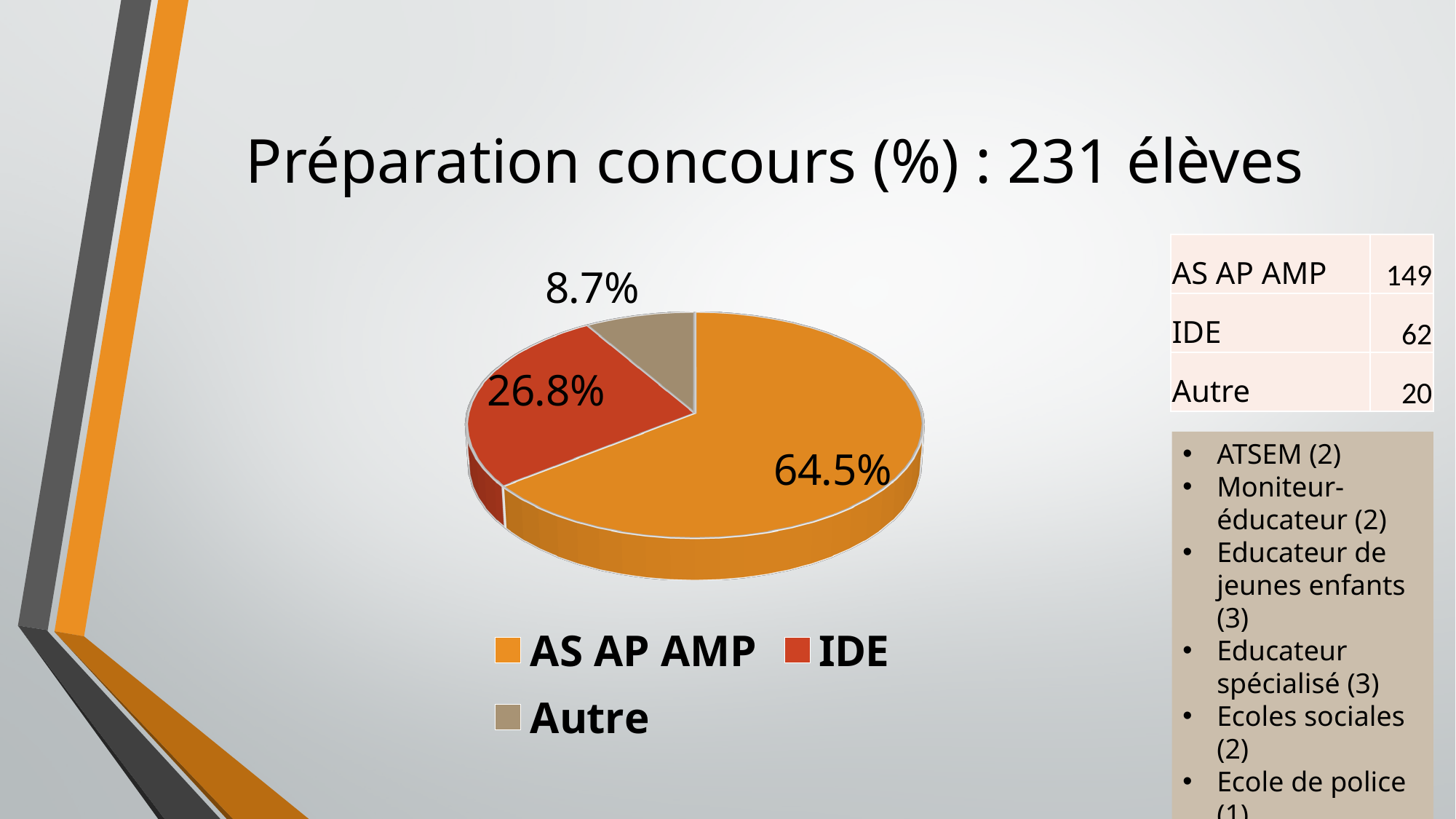
Which slice is larger, IDE or Autre? IDE What type of chart is shown on the slide? Pie chart What is the title of the slide containing the pie chart? Préparation concours (%) : 231 élèves Which category has the smallest slice in the pie chart? Autre What colour is the IDE slice in the pie chart? Red What percentage of the pie chart does the IDE slice represent? 26.8% How many slices does the pie chart have? 3 How many entries does the legend of the pie chart list? 3 What is the difference in percentage points between the AS AP AMP slice and the IDE slice? 37.7 What percentage of the pie chart does the Autre slice represent? 8.7% Which category has the largest slice in the pie chart? AS AP AMP What percentage of the pie chart does the AS AP AMP slice represent? 64.5%